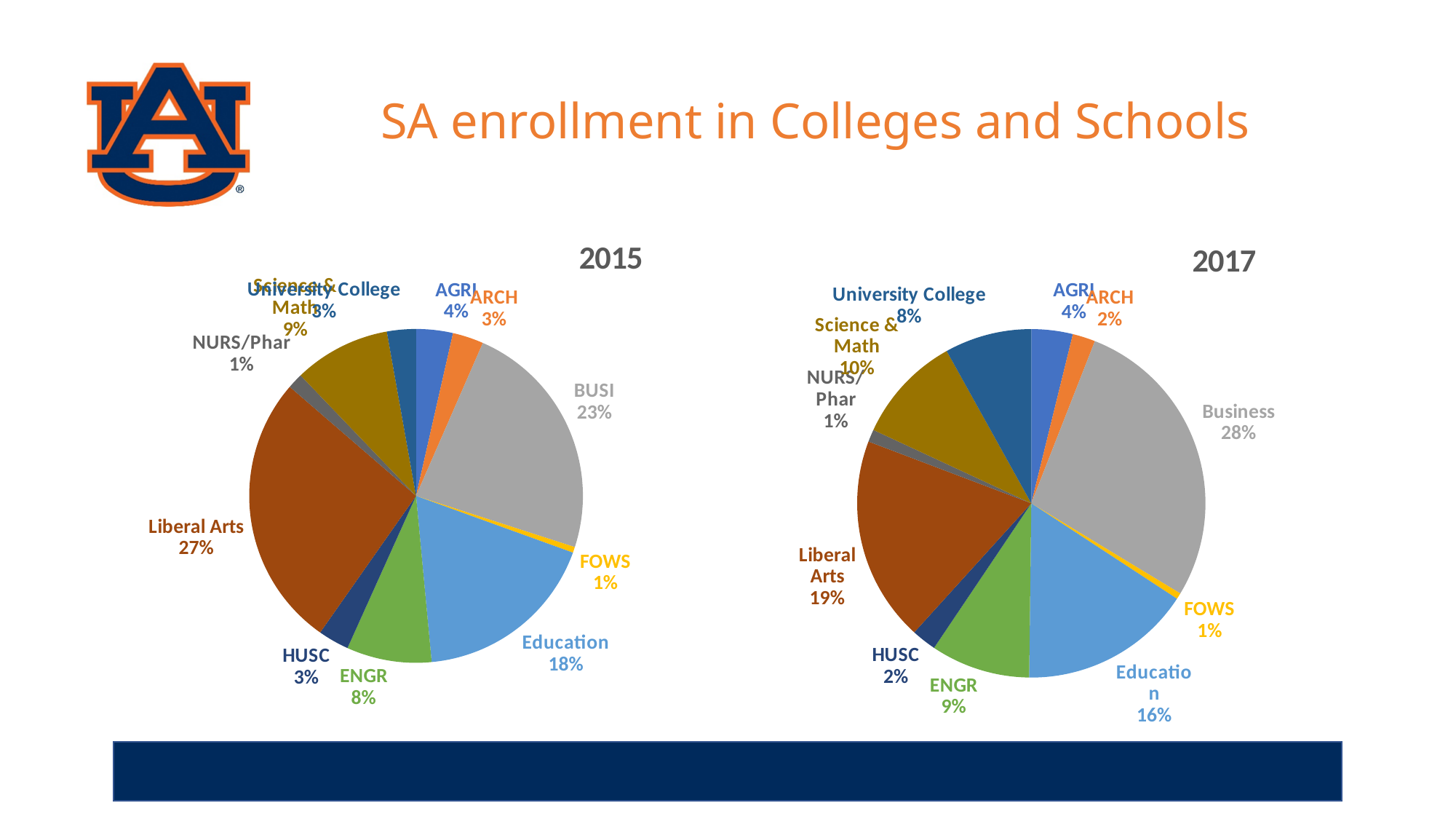
How many colleges or schools are shown as slices in the 2015 pie chart? 11 In the 2015 pie chart, what percentage is shown for Education? 18% In the 2015 pie chart, what is the difference in percentage points between BUSI and Education? 5 In the 2017 pie chart, which is larger, the share for Liberal Arts or the share for Education? Liberal Arts In the 2015 pie chart, what share of SA enrollment is in Liberal Arts? 27% What type of chart is used to show the 2017 SA enrollment? Pie chart In the 2015 pie chart, which college or school has the largest share? Liberal Arts In the 2017 pie chart, what percentage is shown for Science & Math? 10% In the 2017 pie chart, which college or school has the largest share? Business In the 2017 pie chart, what is the difference in percentage points between Business and Liberal Arts? 9 What is the title of the slide containing the two pie charts? SA enrollment in Colleges and Schools In the 2017 pie chart, what share of SA enrollment is in Business? 28%